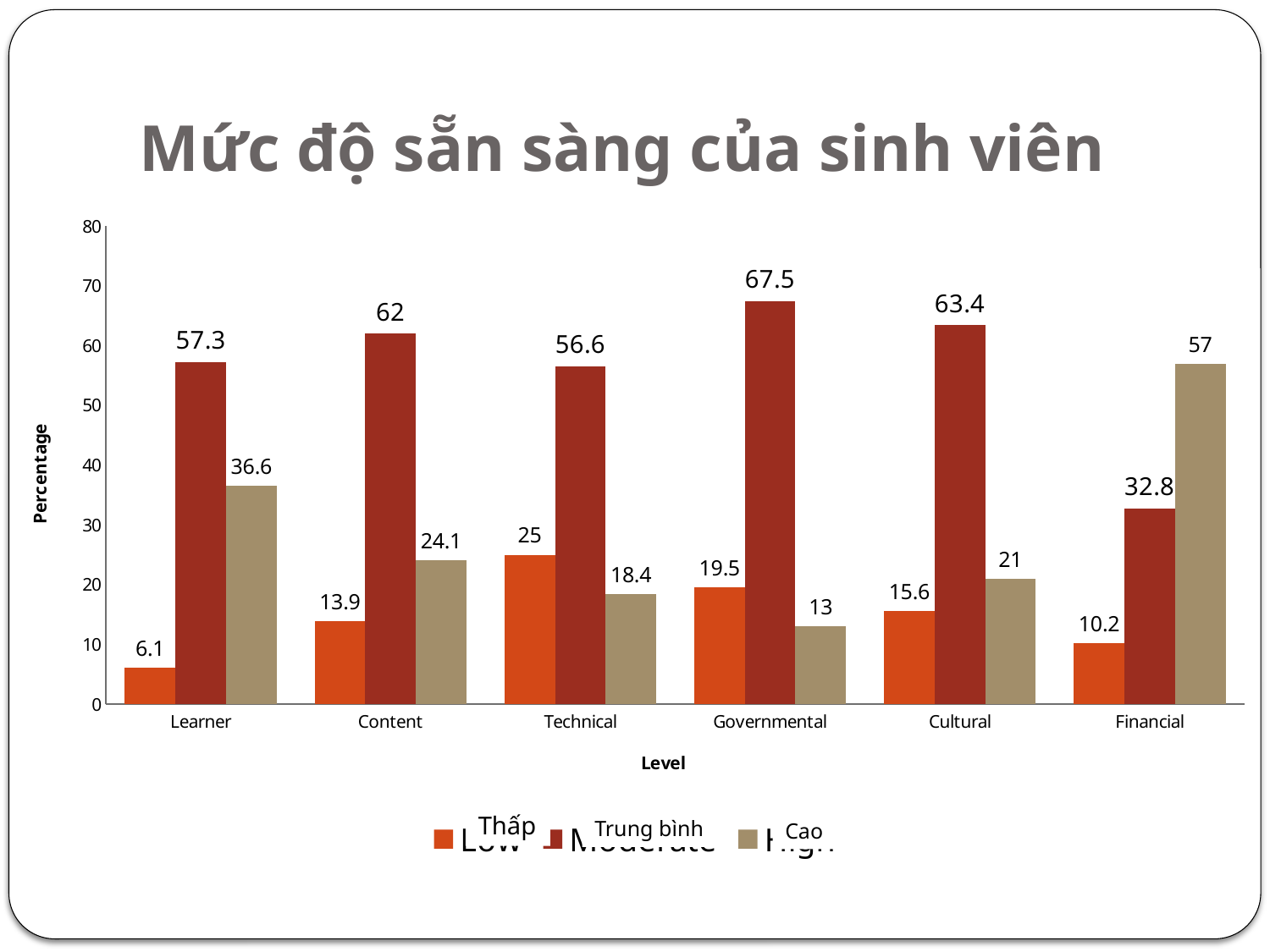
Is the High (Cao) value for Learner greater or less than 30? greater What is the Moderate (Trung bình) value for Governmental? 67.5 What kind of chart is shown on the slide? Bar chart What is the difference between the Moderate (Trung bình) and High (Cao) values for Content? 37.9 How many series does the legend list? 3 What is the Low (Thấp) value for Learner? 6.1 Which is larger for Financial: the Moderate (Trung bình) value or the High (Cao) value? High (Cao) Which category has the highest Moderate (Trung bình) value? Governmental How many categories are shown on the x axis? 6 What is the title of the chart? Mức độ sẵn sàng của sinh viên Which category has the lowest Low (Thấp) value? Learner What is the High (Cao) value for Financial? 57